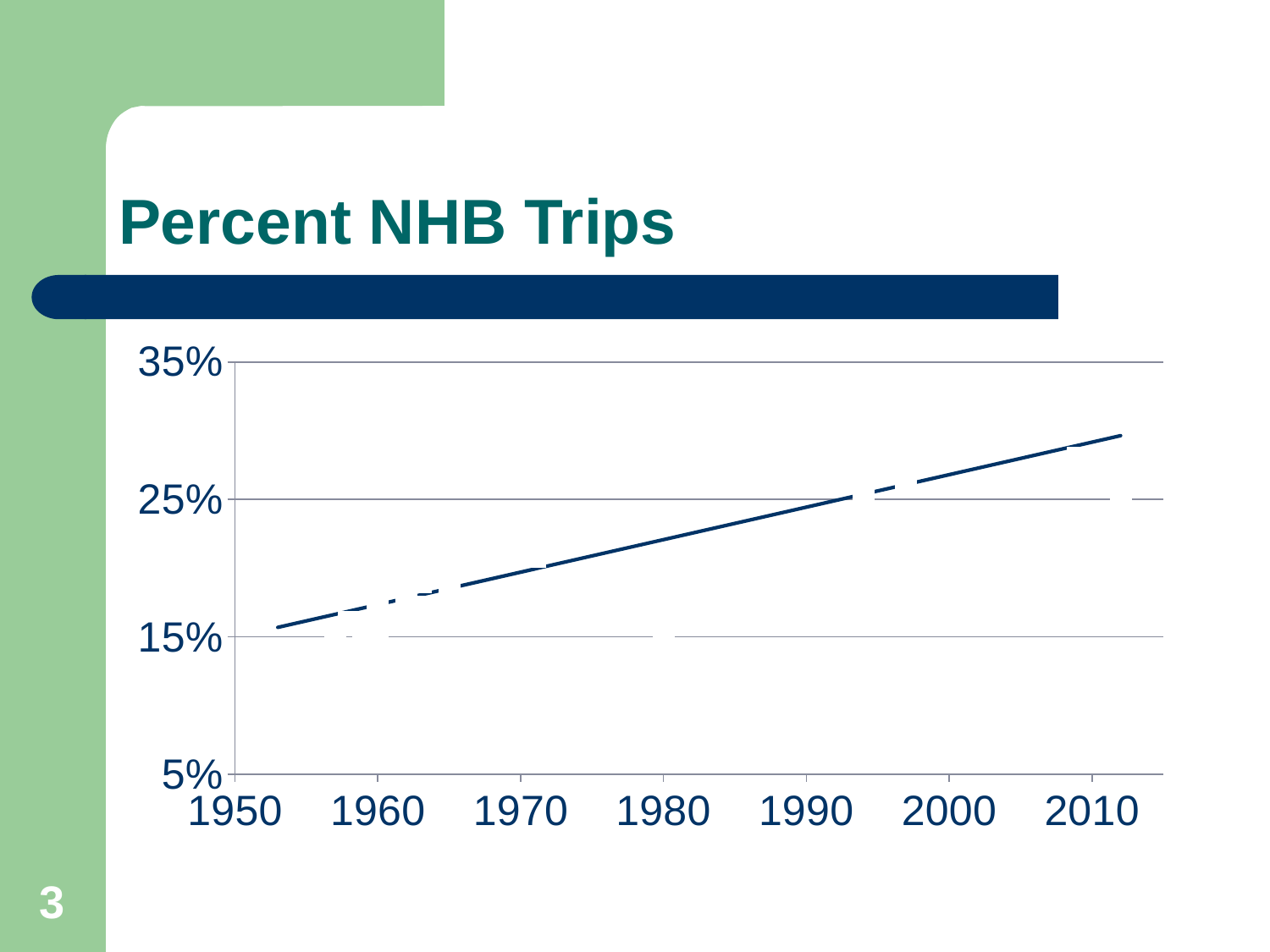
Is the value for 2000 greater or less than 35%? less What is the title of the chart? Percent NHB Trips At which end of the x axis does the line reach its highest value, the left (1950s) or the right (2010s)? the right (2010s) Which year has the larger value, 1960 or 2010? 2010 What kind of chart is shown on the slide? line chart Is the value for 1980 greater or less than 25%? less Is the value for 1960 greater or less than 15%? greater Do the values rise or fall from 1950 to 2010 along the x axis? rise What colour is the plotted line? dark blue Which year has the larger value, 1970 or 1990? 1990